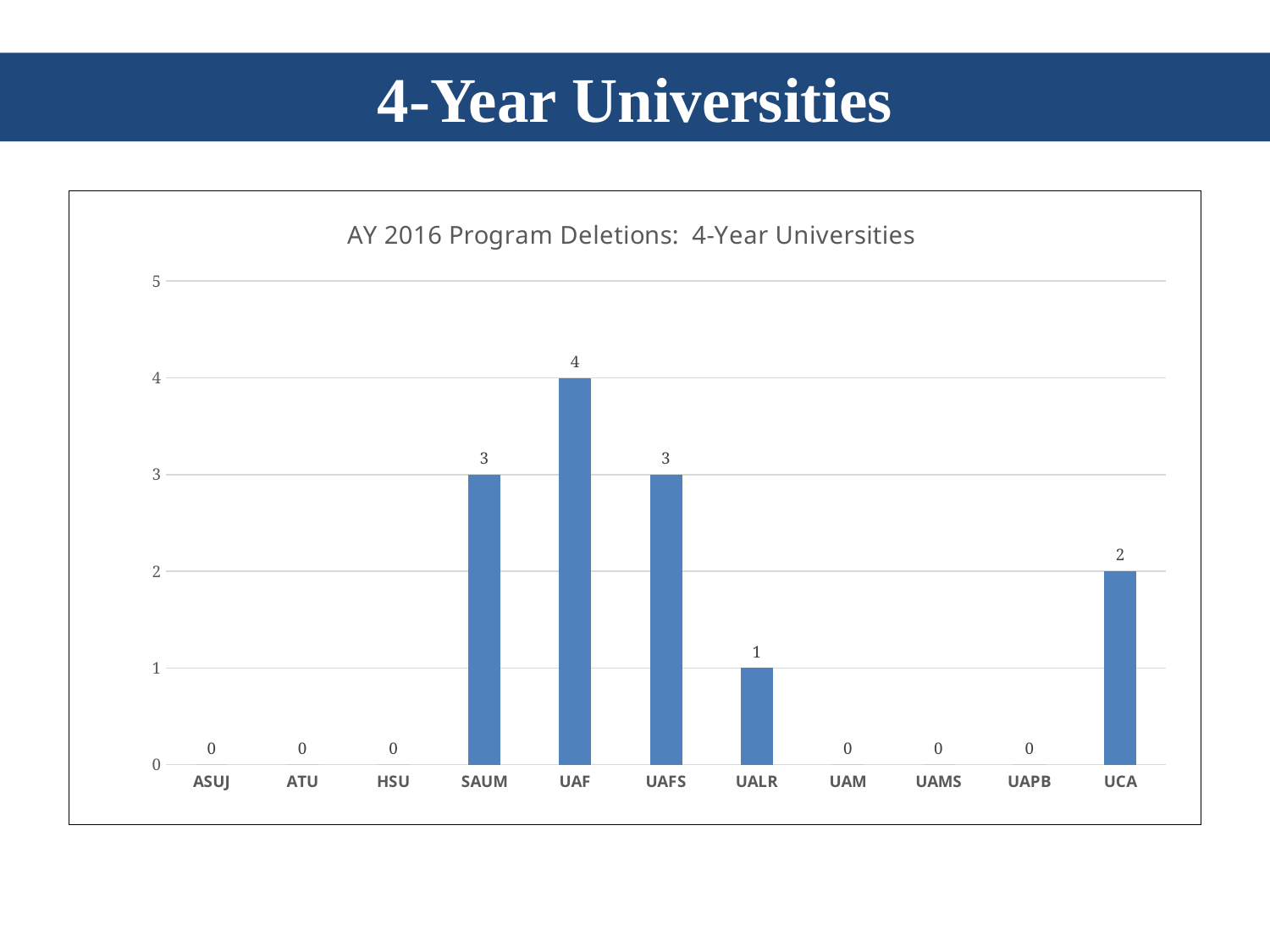
What is the value for UAF? 4 What is the difference between the values for UAF and UCA? 2 What is the value for UALR? 1 What is the value for UCA? 2 What is the difference between the values for SAUM and UALR? 2 How many universities have a value of 0? 6 Which university has the highest number of program deletions? UAF What is the title of the chart? AY 2016 Program Deletions: 4-Year Universities What kind of chart is shown on the slide? Bar chart How many universities are shown on the x axis? 11 Which is larger, the value for UAFS or the value for UALR? UAFS What is the value for SAUM? 3